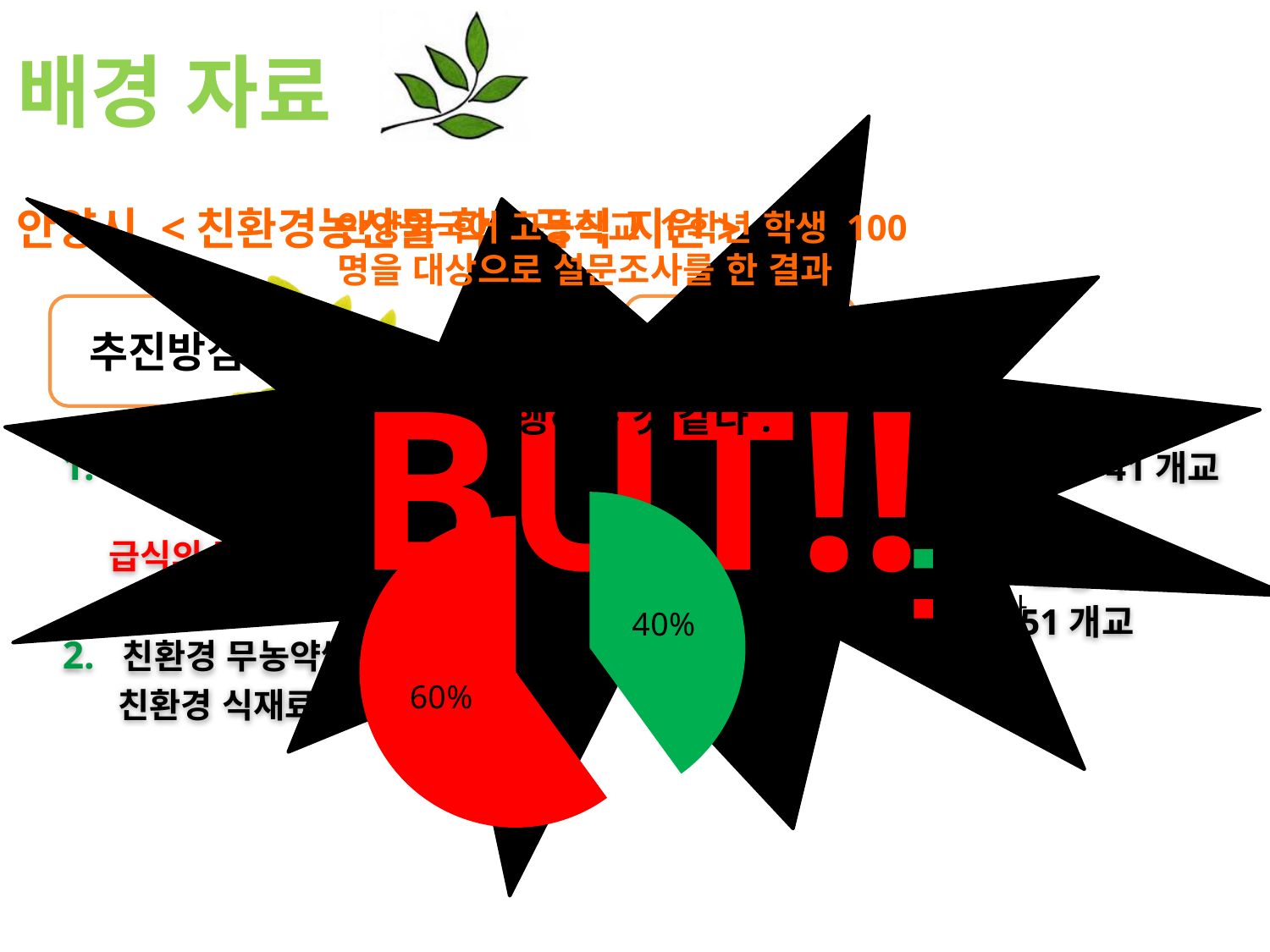
Which slice of the pie chart is the largest? the red slice (60%) What share of the pie does the green slice represent? 40% What colours are the two slices of the pie chart? red and green How many slices does the pie chart have? 2 Which is larger in the pie chart, the red slice or the green slice? the red slice What value is labelled on the green slice of the pie chart? 40% What value is labelled on the red slice of the pie chart? 60% What kind of chart is shown on the slide? pie chart Is the value of the red slice of the pie chart greater or less than 50%? greater What is the difference in percentage points between the red slice and the green slice of the pie chart? 20 percentage points Which slice of the pie chart is the smallest? the green slice (40%)